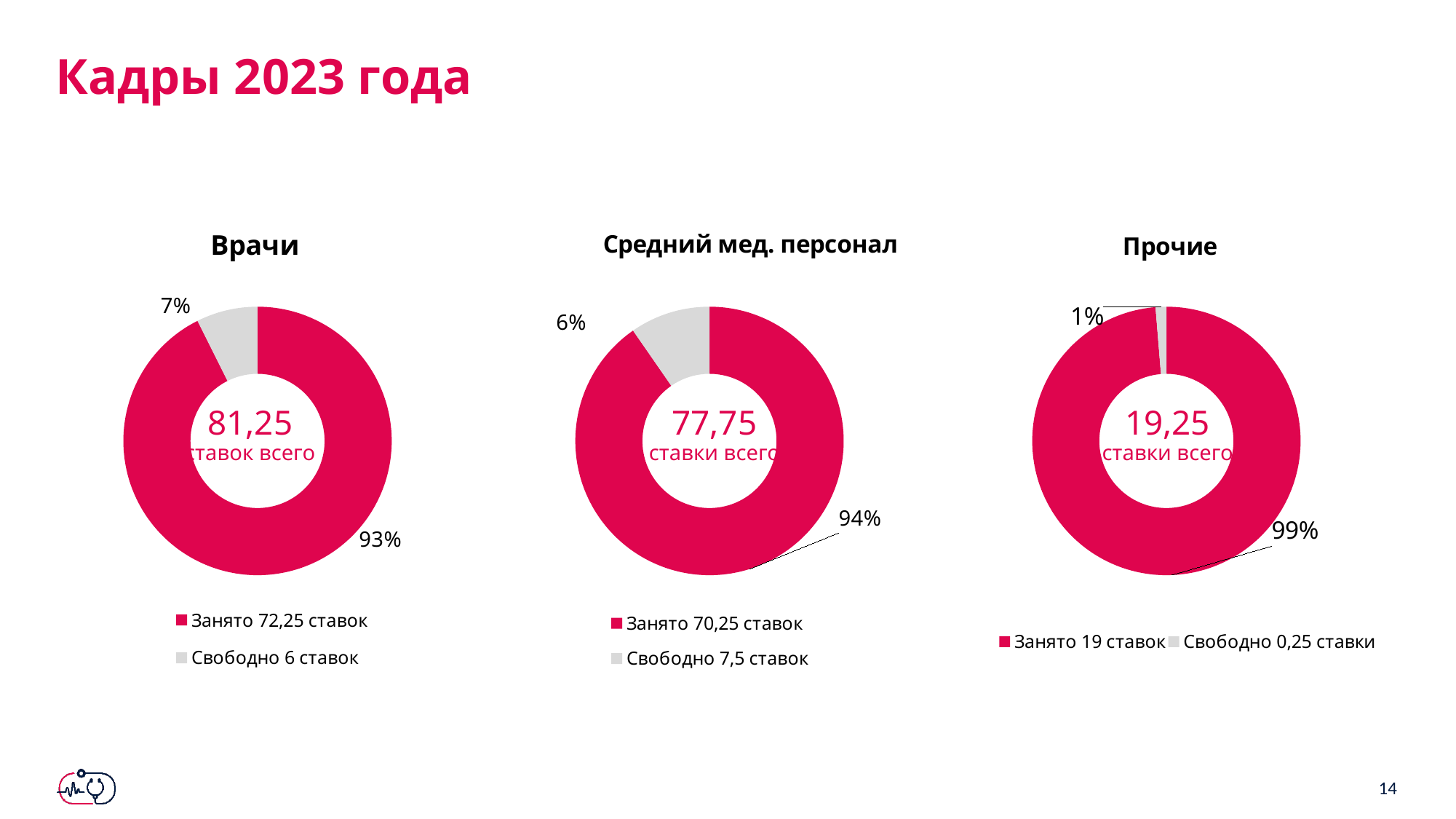
На диаграмме «Прочие» сколько ставок свободно согласно легенде? 0,25 ставки На диаграмме «Прочие» какая доля приходится на занятые ставки? 99% На диаграмме «Средний мед. персонал» какая доля приходится на свободные ставки? 6% На диаграмме «Средний мед. персонал» сколько всего ставок указано в центре? 77,75 На диаграмме «Врачи» какая доля приходится на свободные ставки? 7% Сколько сегментов на диаграмме «Врачи»? 2 Какого типа диаграмма «Средний мед. персонал»? Кольцевая (круговая) диаграмма На диаграмме «Средний мед. персонал» какой сегмент больше — занятые или свободные ставки? Занятые На диаграмме «Прочие» какой сегмент самый маленький? Свободно 0,25 ставки Сколько элементов перечислено в легенде диаграммы «Прочие»? 2 На диаграмме «Врачи» на сколько процентных пунктов доля занятых ставок больше доли свободных? 86 На диаграмме «Врачи» какая доля приходится на занятые ставки? 93%